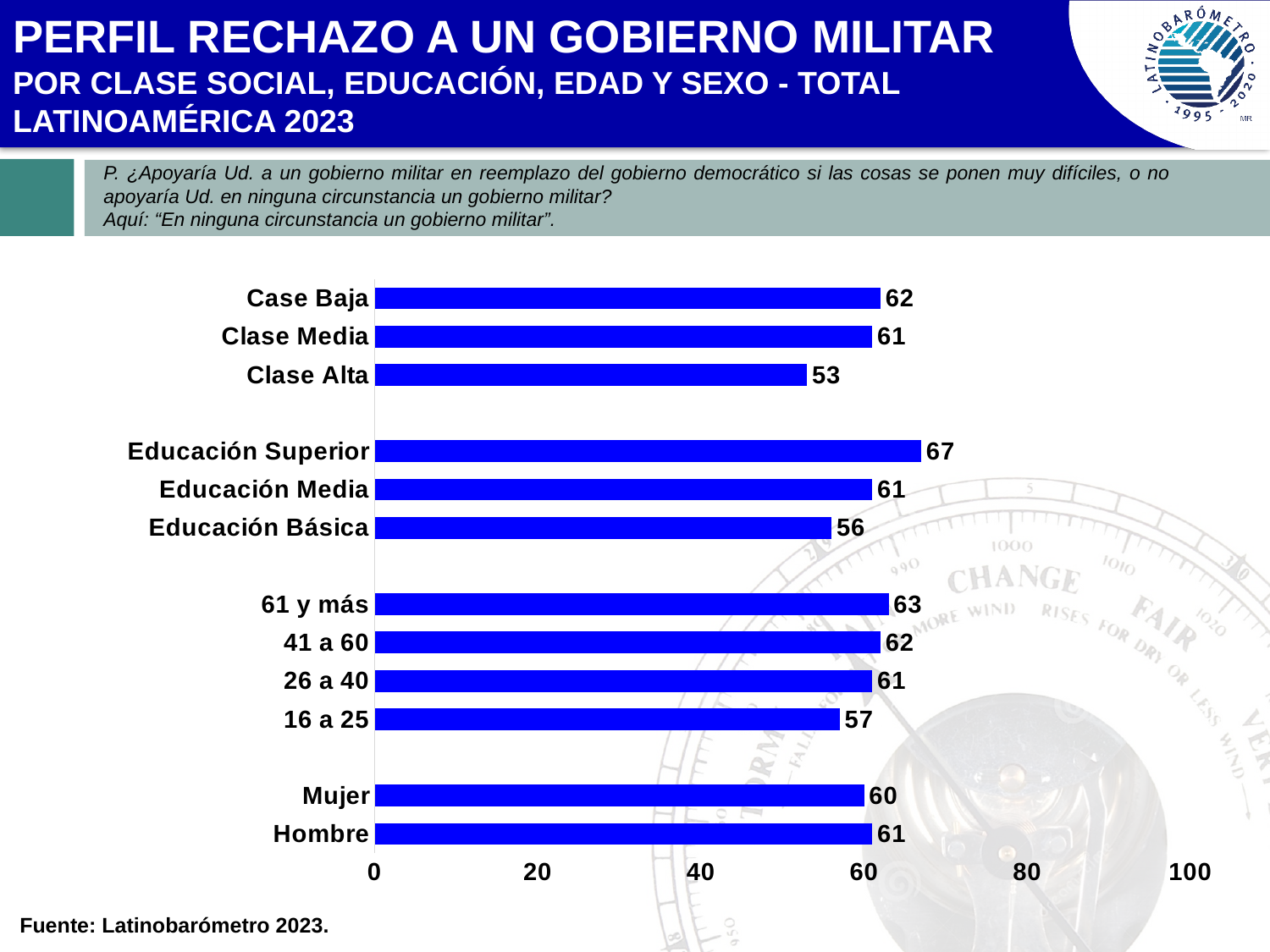
What is the value for Educación Superior? 67 How many categories are plotted in the chart? 12 What is the source cited below the chart? Latinobarómetro 2023 Which category has the lowest value? Clase Alta What is the difference between the values for Educación Superior and Educación Básica? 11 What is the value for Clase Alta? 53 What is the value for 16 a 25? 57 What is the value for Mujer? 60 Which is larger, the value for 61 y más or the value for 16 a 25? 61 y más What kind of chart is shown on the slide? bar chart Which category has the highest value? Educación Superior Is the value for Clase Alta greater or less than 60? less